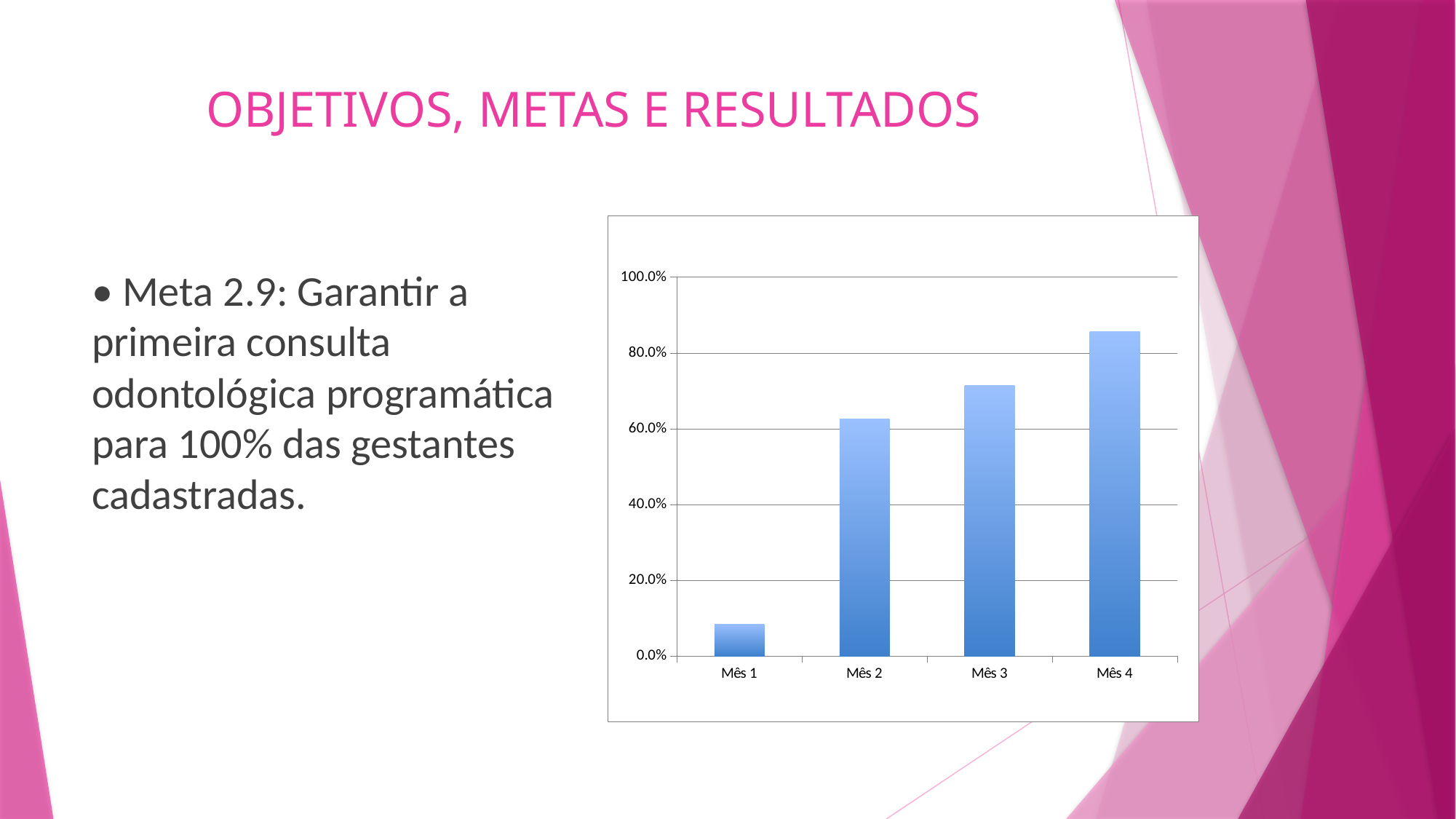
Which month has the lowest bar in the chart? Mês 1 Is the value for Mês 4 greater or less than 80.0%? greater Which is larger, the value for Mês 1 or the value for Mês 4? Mês 4 What kind of chart is shown on the slide? bar chart Which is larger, the value for Mês 2 or the value for Mês 3? Mês 3 Which month has the highest bar in the chart? Mês 4 How many categories are plotted on the x axis of the chart? 4 Is the value for Mês 1 greater or less than 20.0%? less Is the value for Mês 3 greater or less than 80.0%? less Do the values rise or fall from Mês 1 to Mês 4? rise What is the highest value shown on the y axis of the chart? 100.0%